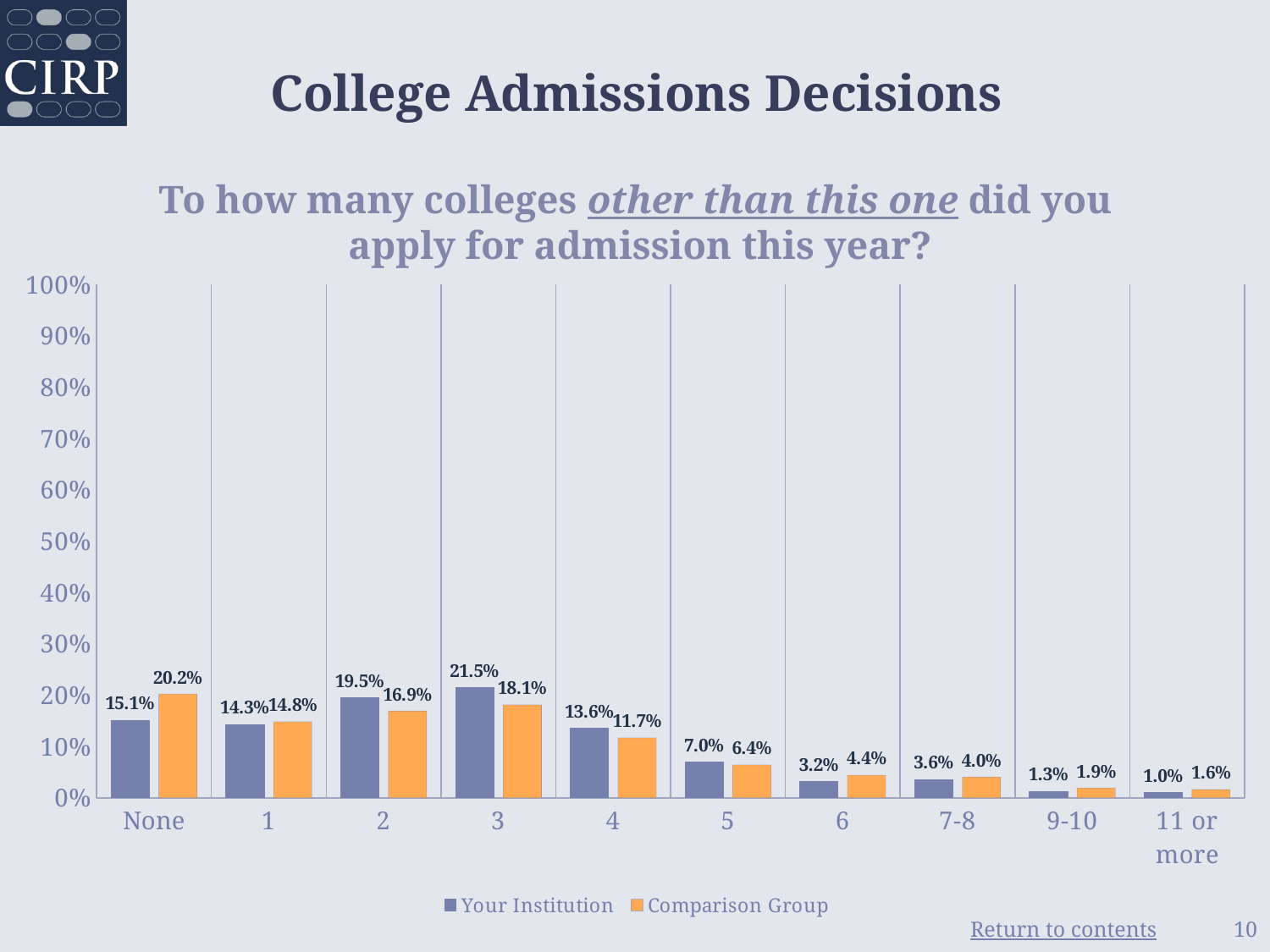
What is the value for Your Institution in the '7-8' category? 3.6% Which category has the highest value for Your Institution? 3 What kind of chart is shown on the slide? bar chart How many series does the legend list? 2 What is the value for Your Institution in the '3' category? 21.5% How many categories are shown on the x axis? 10 Which category has the lowest value for Comparison Group? 11 or more Is the value for Your Institution in the '3' category greater or less than 20%? greater What is the value for Comparison Group in the 'None' category? 20.2% What colour are the Comparison Group bars? orange What is the difference between Your Institution and Comparison Group in the 'None' category? 5.1% Which is larger in the '2' category: Your Institution or Comparison Group? Your Institution